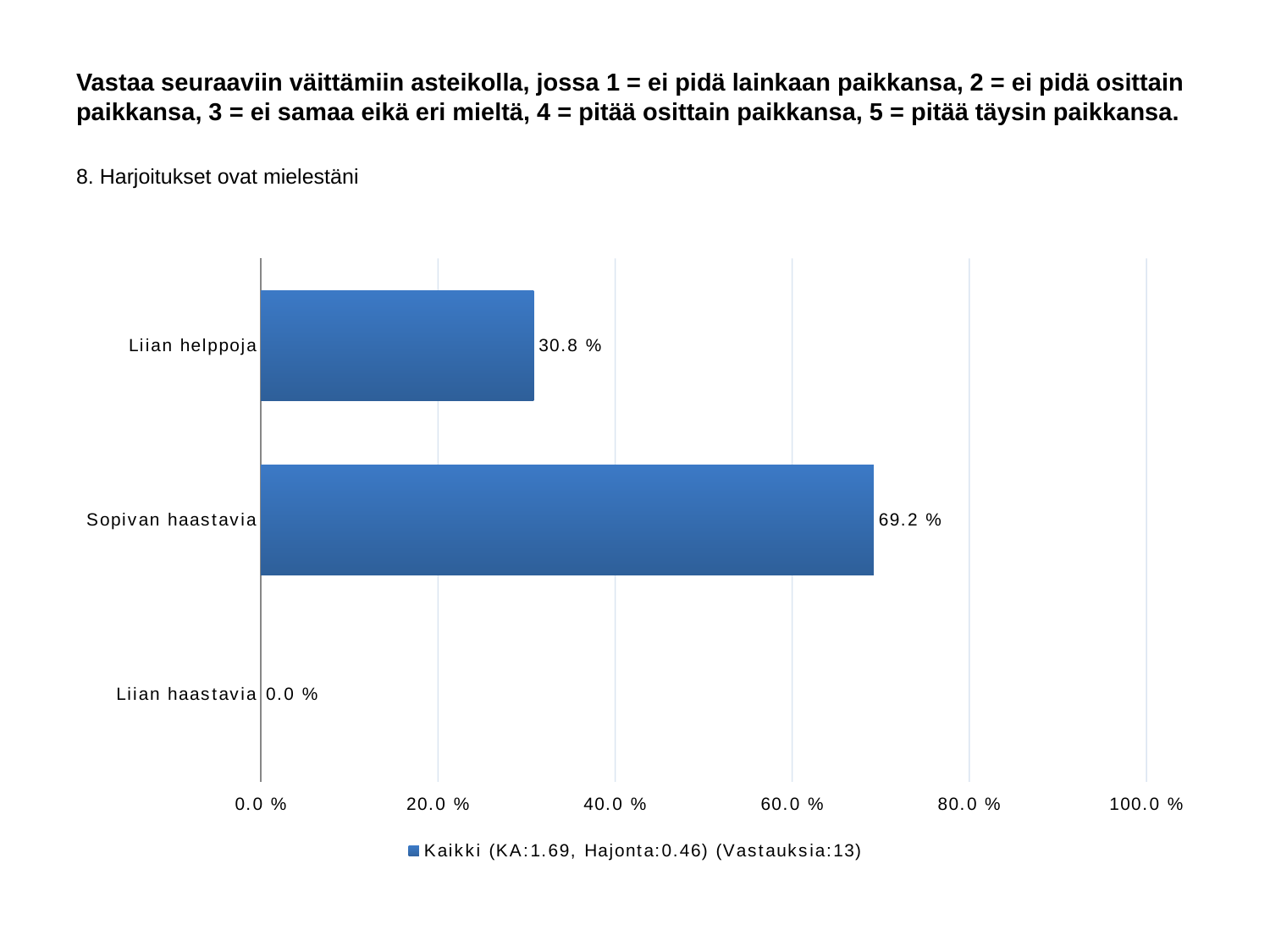
What kind of chart is shown on the slide? bar chart How many categories are shown in the chart? 3 What is the value for Liian helppoja? 30.8 % Which category has the highest value? Sopivan haastavia How many series does the legend list? 1 How many responses (Vastauksia) does the legend report? 13 Which category has the lowest value? Liian haastavia What is the difference between the values for Sopivan haastavia and Liian helppoja? 38.4 % Is the value for Sopivan haastavia greater or less than 60.0 %? greater What is the value for Liian haastavia? 0.0 % Which is larger, the value for Liian helppoja or the value for Sopivan haastavia? Sopivan haastavia What is the value for Sopivan haastavia? 69.2 %